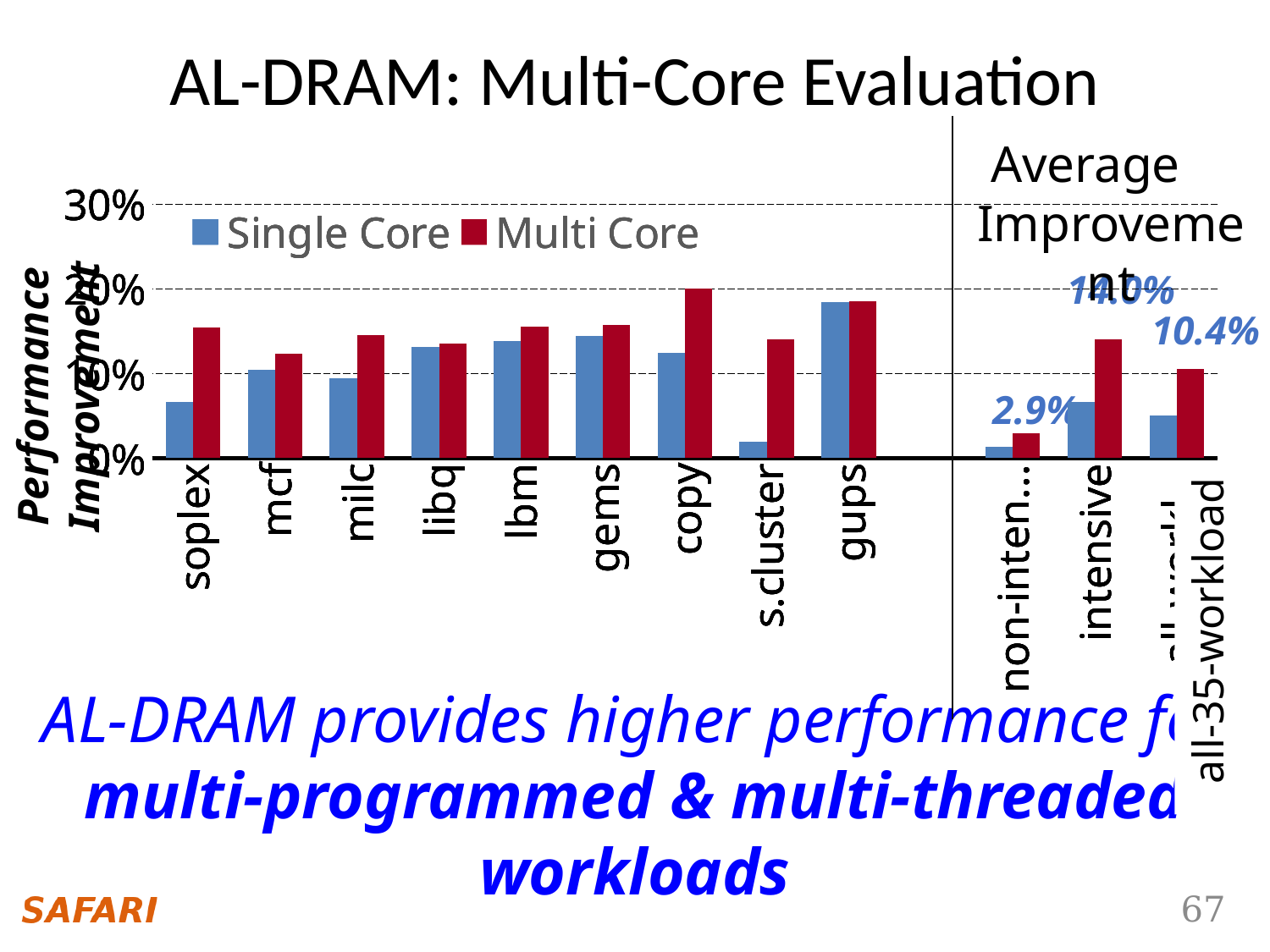
Is the Single Core value for soplex greater or less than 10%? less How many categories are shown along the x axis? 12 Which colour represents the Multi Core series? red What are the two series named in the legend? Single Core and Multi Core What average improvement value is annotated above the intensive category? 14.0% Which category has the highest Single Core value? gups For soplex, which is larger: the Single Core value or the Multi Core value? Multi Core What kind of chart is shown on the slide? bar chart Which category has the highest Multi Core value? copy Is the Single Core value for s.cluster greater or less than 10%? less Is the Multi Core value for soplex greater or less than 10%? greater How many series does the legend list? 2